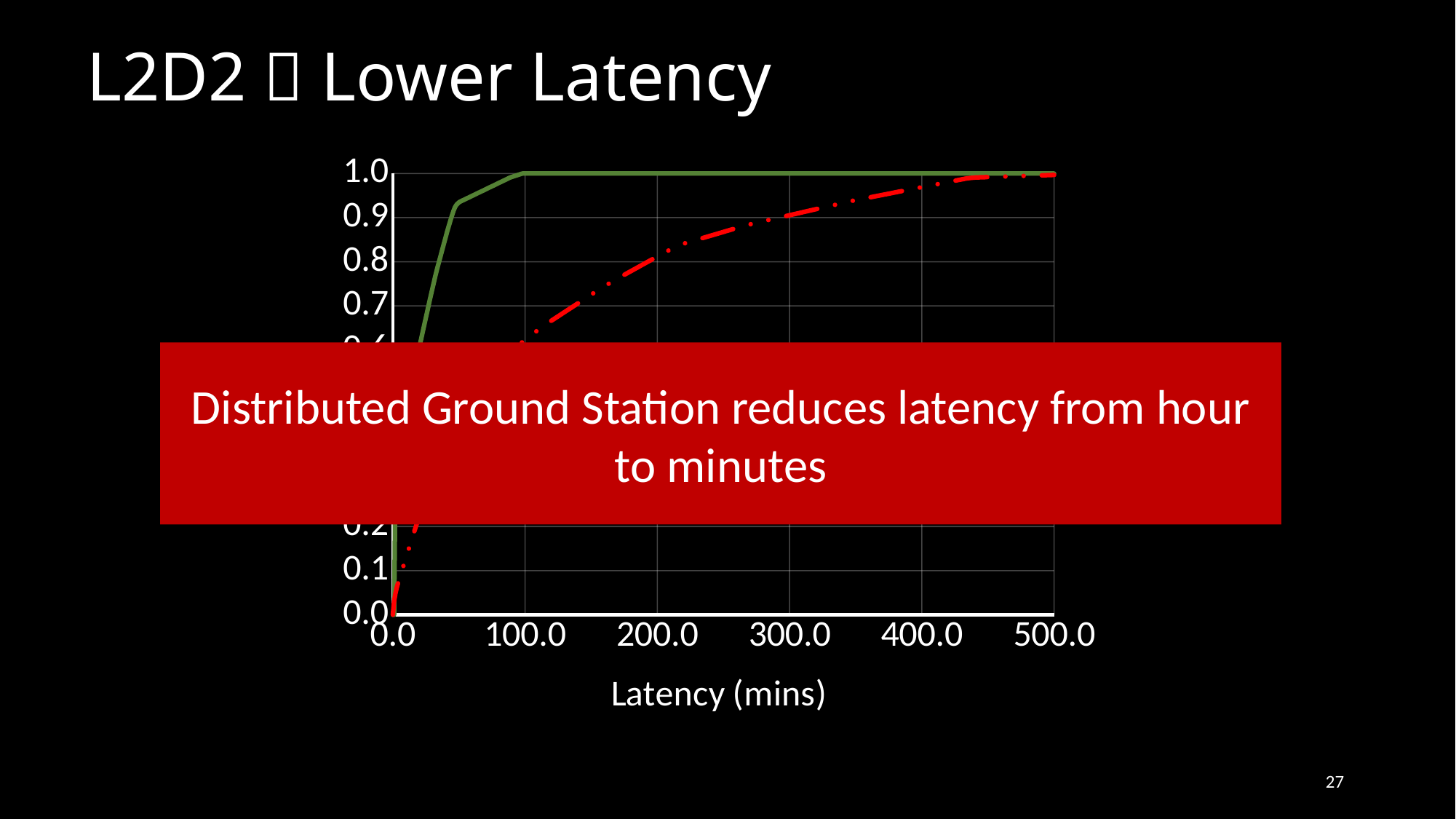
Is the value of the green line at a latency of 100.0 mins greater or less than 0.9? greater What is the highest value shown on the x axis of the chart? 500.0 How many lines are plotted on the chart? 2 What kind of chart is shown on the slide? line chart What is the label of the x axis of the chart? Latency (mins) At a latency of 100.0 mins, which line has the higher value, the green line or the red dashed line? green line Is the value of the green line at a latency of 50.0 mins greater or less than 0.8? greater Is the value of the red dashed line at a latency of 100.0 mins greater or less than 0.9? less How many tick labels are shown on the x axis of the chart? 6 Do the values of the green line rise or fall as latency increases along the x axis? rise What is the highest value shown on the y axis of the chart? 1.0 Do the values of the red dashed line rise or fall as latency increases along the x axis? rise